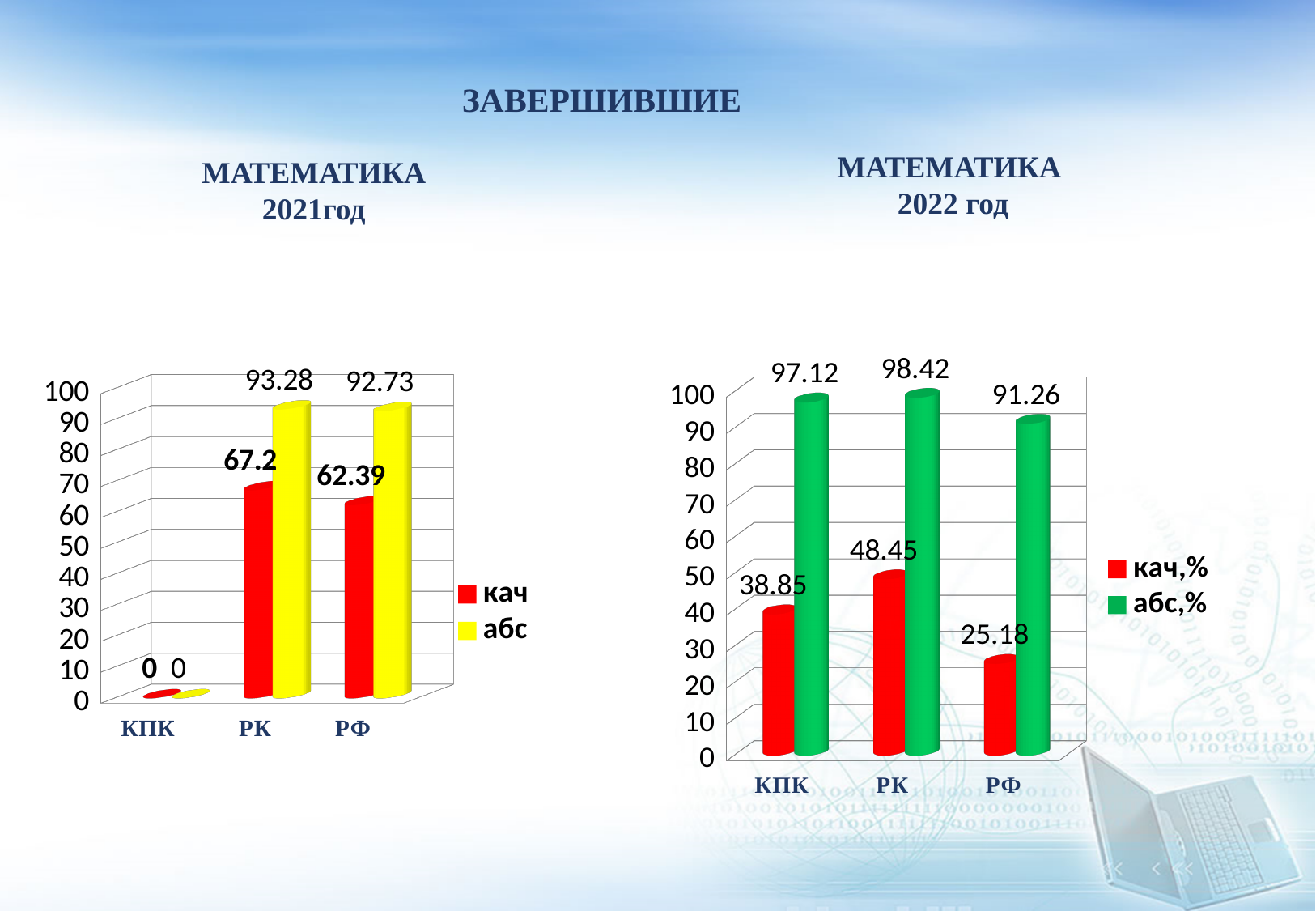
In the МАТЕМАТИКА 2021год chart, what is the difference between абс and кач for РК? 26.08 In the МАТЕМАТИКА 2021год chart, what is the value of абс for РК? 93.28 In the МАТЕМАТИКА 2022 год chart, what is the difference between кач,% for РК and кач,% for КПК? 9.6 In the МАТЕМАТИКА 2021год chart, what is the value of кач for РФ? 62.39 What type of chart is the МАТЕМАТИКА 2021год chart? Bar chart In the МАТЕМАТИКА 2022 год chart, what is the value of кач,% for РФ? 25.18 In the МАТЕМАТИКА 2022 год chart, which category has the lowest кач,% value? РФ In the МАТЕМАТИКА 2022 год chart, which is larger, абс,% for КПК or абс,% for РФ? абс,% for КПК In the МАТЕМАТИКА 2021год chart, which category has the highest кач value? РК In the МАТЕМАТИКА 2022 год chart, what is the value of абс,% for РК? 98.42 In the МАТЕМАТИКА 2021год chart, what is the value of кач for КПК? 0 How many series does the legend of the МАТЕМАТИКА 2022 год chart list? 2